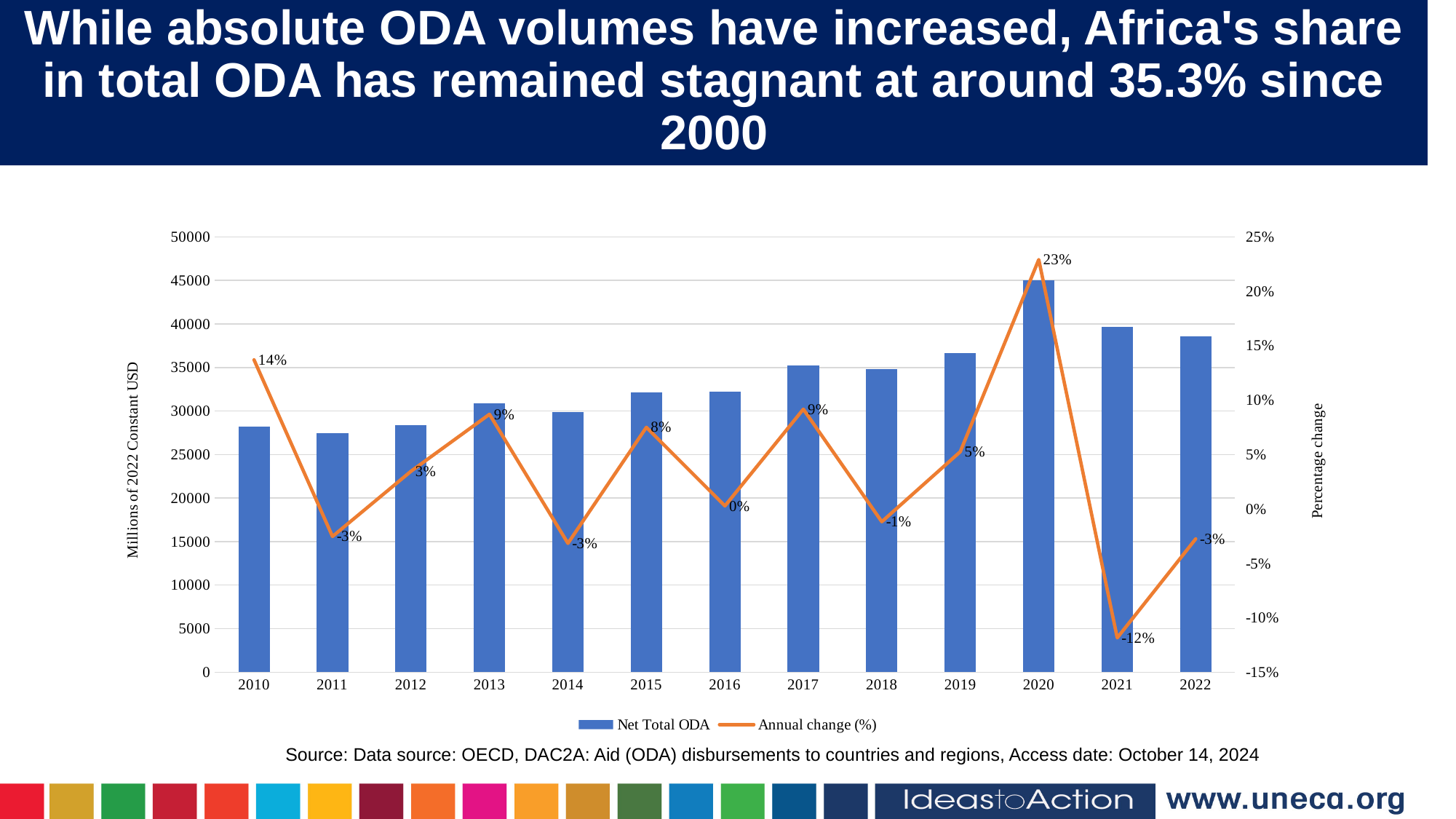
What is the annual change (%) shown for 2016? 0% In which year is the annual change (%) highest? 2020 What is the title of the left vertical axis? Millions of 2022 Constant USD Is the Net Total ODA value for 2011 greater or less than 30000? less What is the difference in percentage points between the annual change in 2020 and the annual change in 2021? 35 percentage points In which year is the annual change (%) lowest? 2021 How many years are shown on the x axis? 13 How many series does the legend list? 2 What is the annual change (%) shown for 2020? 23% What is the annual change (%) shown for 2021? -12% Which year has the taller Net Total ODA bar, 2020 or 2021? 2020 Is the Net Total ODA value for 2020 greater or less than 40000? greater